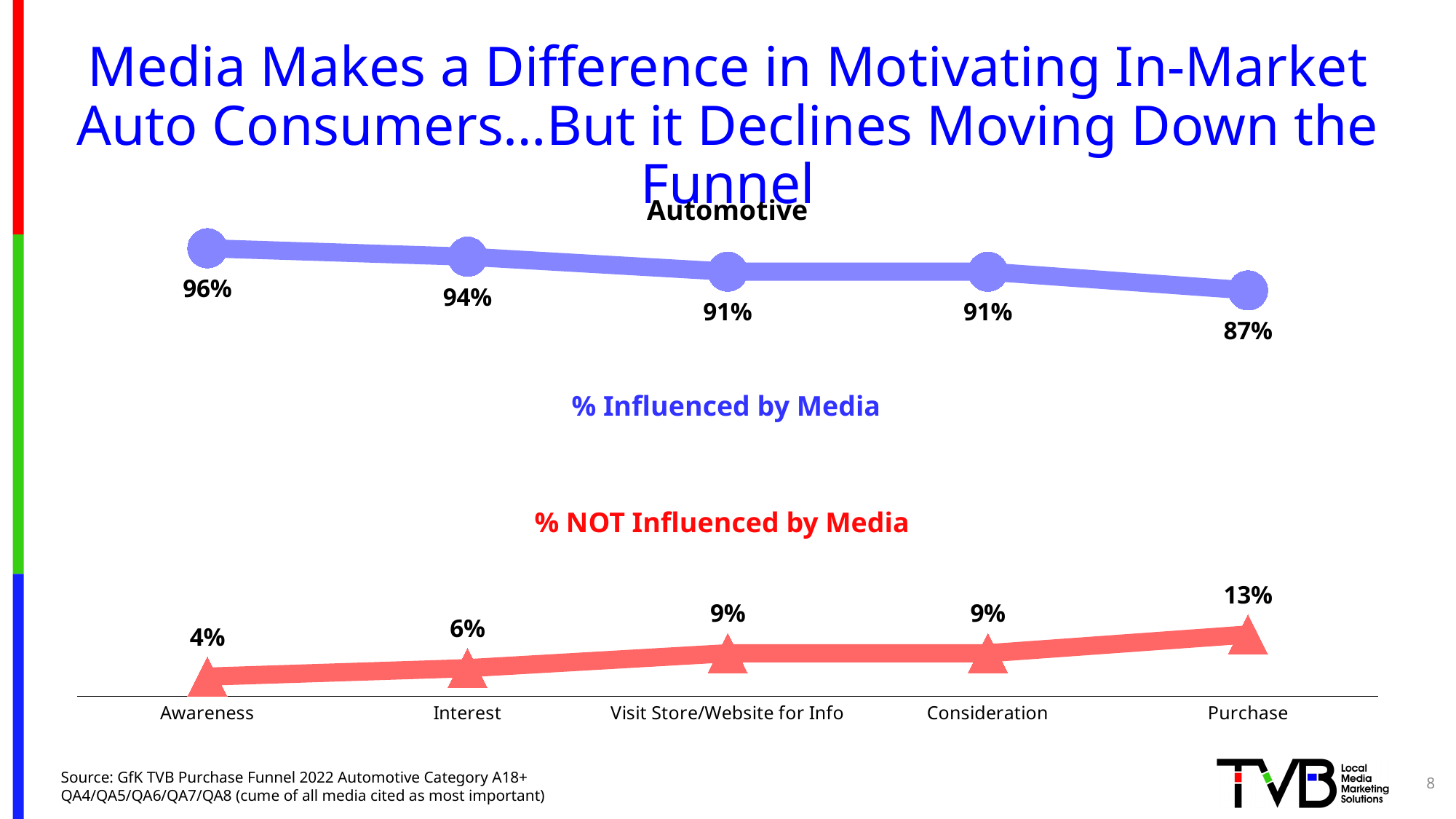
What is the difference between the % Influenced by Media values for Awareness and Purchase? 9% How many funnel stages are shown on the x axis? 5 What is the % NOT Influenced by Media value for Purchase? 13% What is the % Influenced by Media value for Consideration? 91% How many data series are plotted on the chart? 2 Which funnel stage has the highest % NOT Influenced by Media value? Purchase Which funnel stage has the lowest % Influenced by Media value? Purchase Does the % Influenced by Media series rise or fall moving from Awareness to Purchase? Fall What is the % Influenced by Media value for Awareness? 96% Which is larger: the % NOT Influenced by Media value for Visit Store/Website for Info or for Interest? Visit Store/Website for Info What type of chart is shown on the slide? Line chart What is the % NOT Influenced by Media value for Interest? 6%